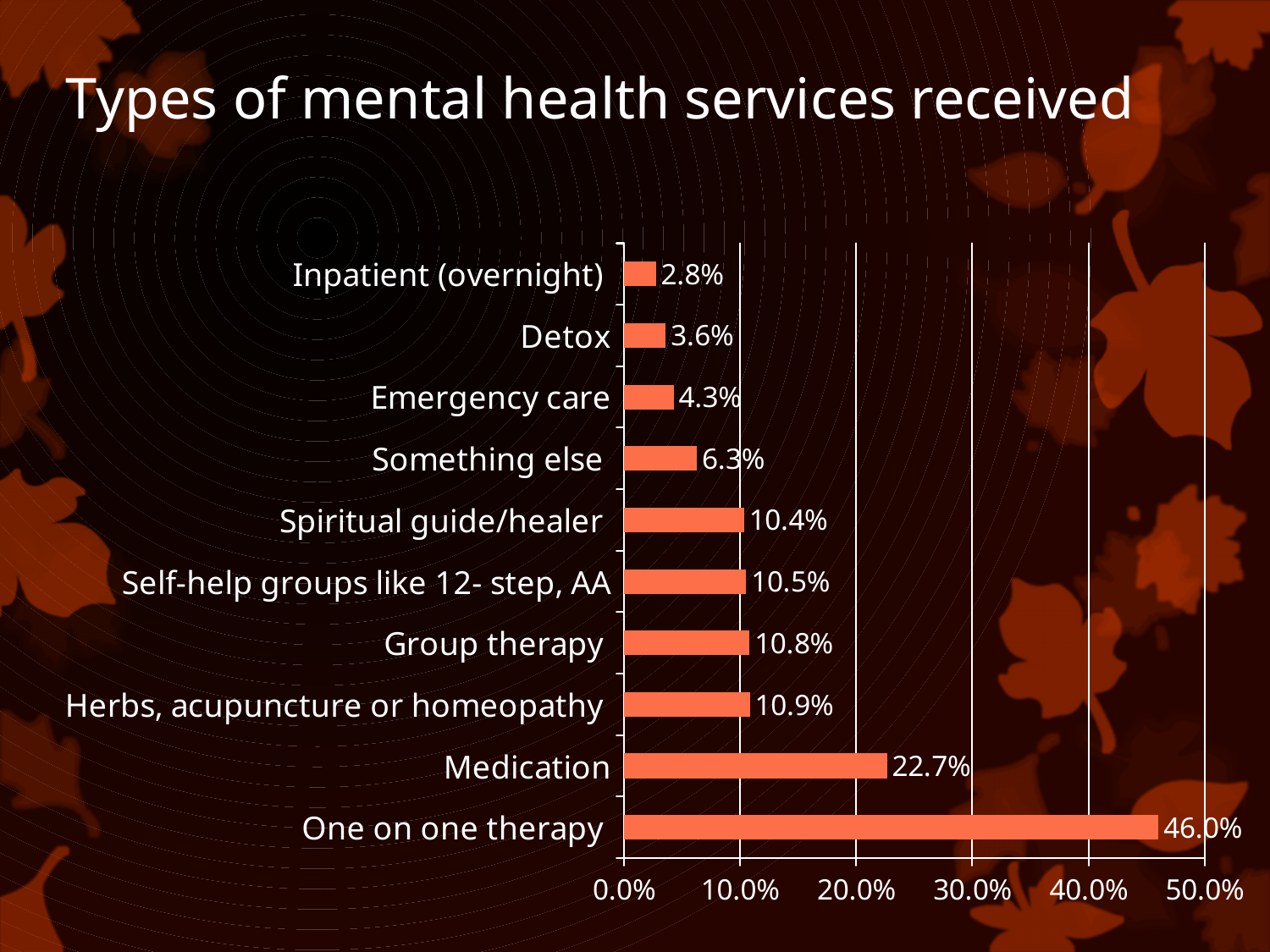
How many types of mental health services are shown in the chart? 10 What percentage received Detox services? 3.6% What percentage received one on one therapy? 46.0% What is the difference between the values for One on one therapy and Medication? 23.3% What is the difference between the values for Something else and Emergency care? 2.0% What is the value for Medication? 22.7% Which type of mental health service has the highest value? One on one therapy Which type of mental health service has the lowest value? Inpatient (overnight) What kind of chart is shown on the slide? Bar chart Is the value for One on one therapy greater or less than 40.0%? greater What is the value for Spiritual guide/healer? 10.4% Which is larger, the value for Medication or the value for Group therapy? Medication